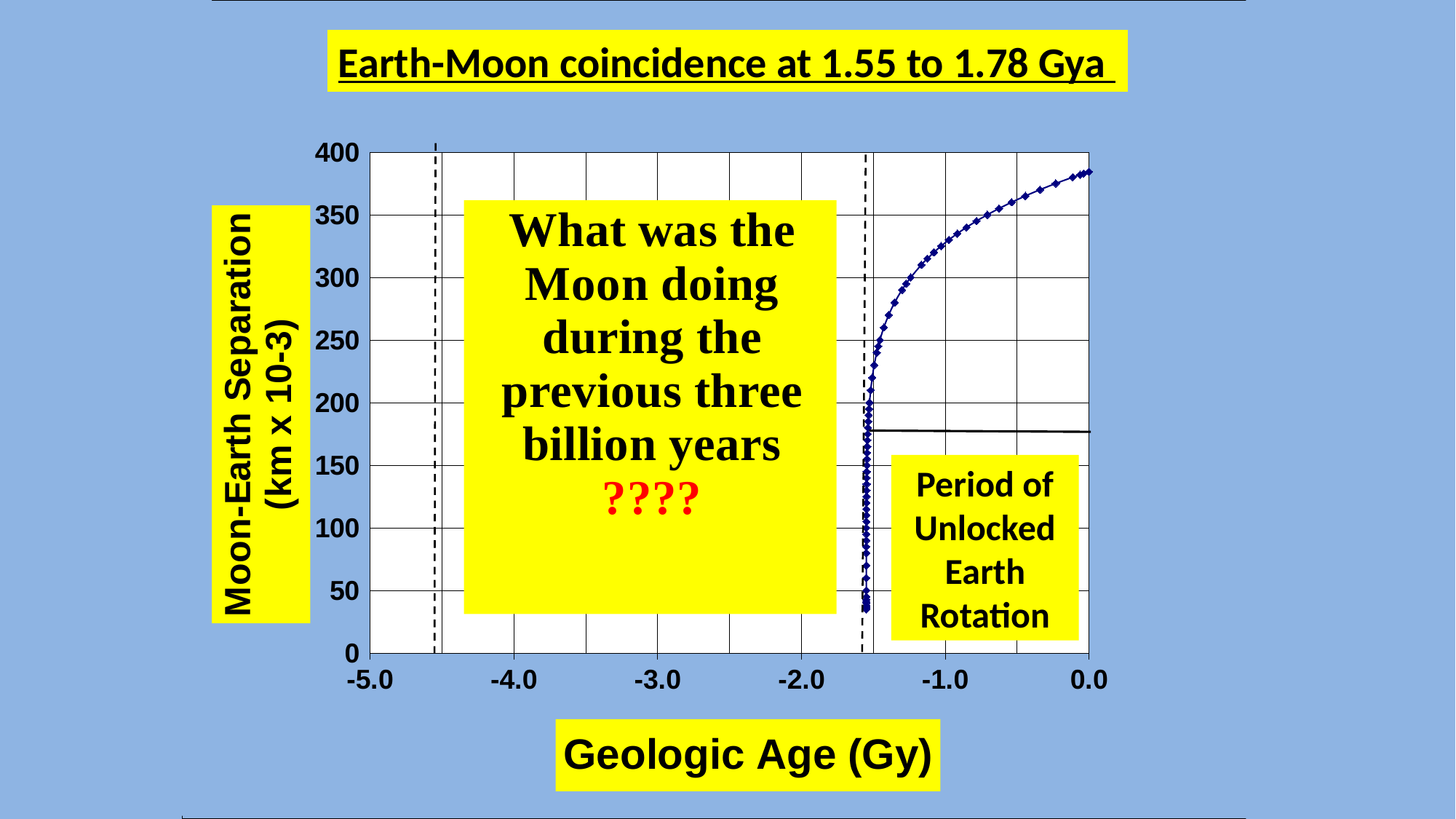
Is the Moon-Earth separation at geologic age -1.5 Gy greater or less than 300? less Is the Moon-Earth separation at geologic age 0.0 Gy greater or less than 350? greater Is the Moon-Earth separation at geologic age -1.0 Gy greater or less than 300? greater At which geologic age on the x axis does the curve reach its highest value? 0.0 What is the title of the chart on the slide? Earth-Moon coincidence at 1.55 to 1.78 Gya What kind of chart is shown on the slide? line chart Does the Moon-Earth separation rise or fall as geologic age moves from -1.5 toward 0.0 Gy? rise What is the label of the y axis? Moon-Earth Separation (km x 10-3) Which is larger, the Moon-Earth separation at -1.0 Gy or at 0.0 Gy? 0.0 Gy What is the highest value shown on the y axis? 400 Which is larger, the Moon-Earth separation at -1.5 Gy or at -1.0 Gy? -1.0 Gy